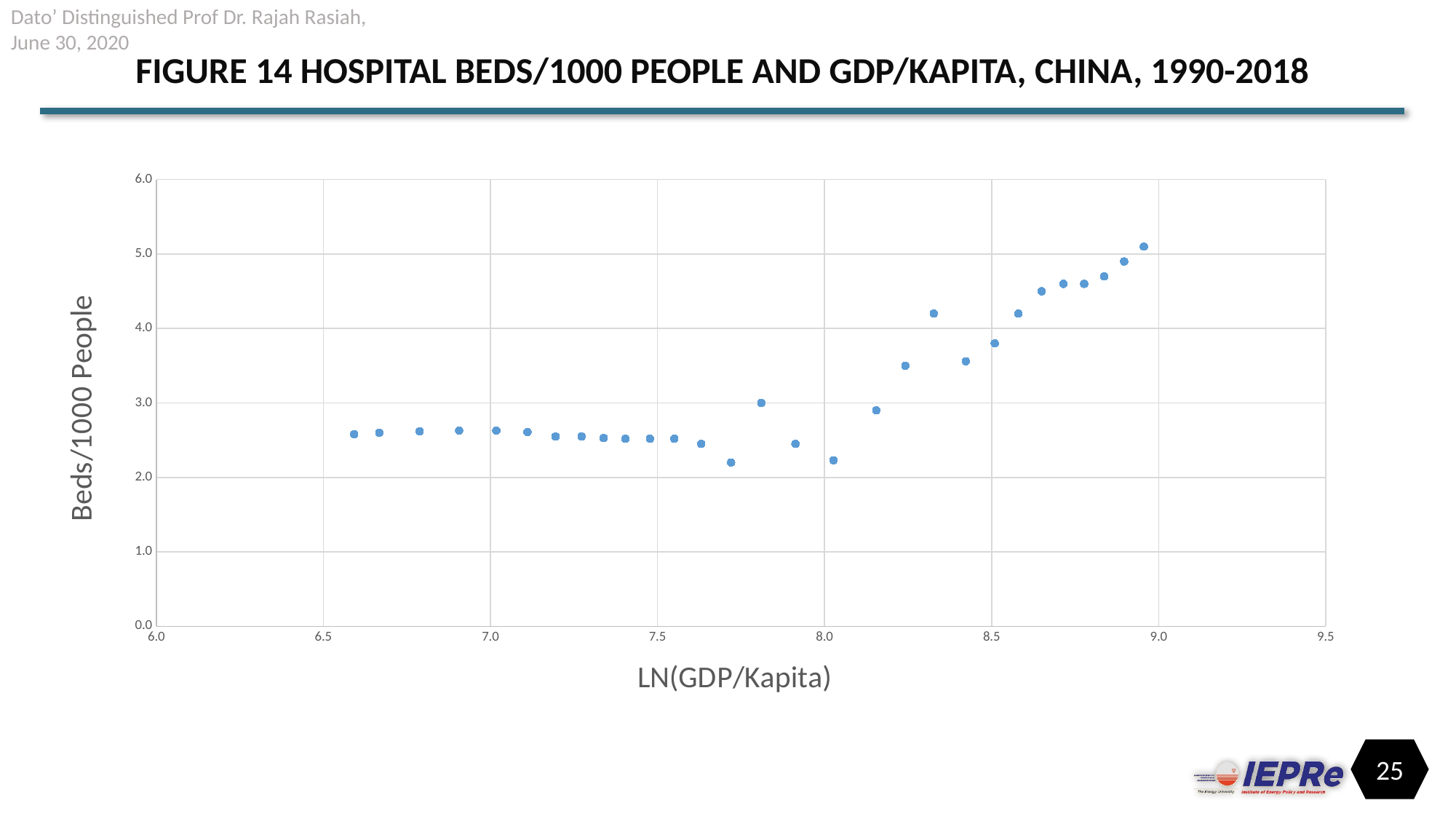
Is the lowest Beds/1000 People value on the chart greater or less than 3.0? less Is the Beds/1000 People value for the point at LN(GDP/Kapita) of about 8.5 greater or less than 3.0? greater Are all plotted Beds/1000 People values greater or less than 6.0? less How many data points are plotted on the chart? 29 What is the label of the vertical axis? Beds/1000 People Overall, do the Beds/1000 People values rise or fall as LN(GDP/Kapita) increases along the x axis? Rise Which point has the highest Beds/1000 People value: the one with the lowest LN(GDP/Kapita) or the one with the highest LN(GDP/Kapita)? The one with the highest LN(GDP/Kapita) What kind of chart is shown on the slide? Scatter chart What is the title of the chart? FIGURE 14 HOSPITAL BEDS/1000 PEOPLE AND GDP/KAPITA, CHINA, 1990-2018